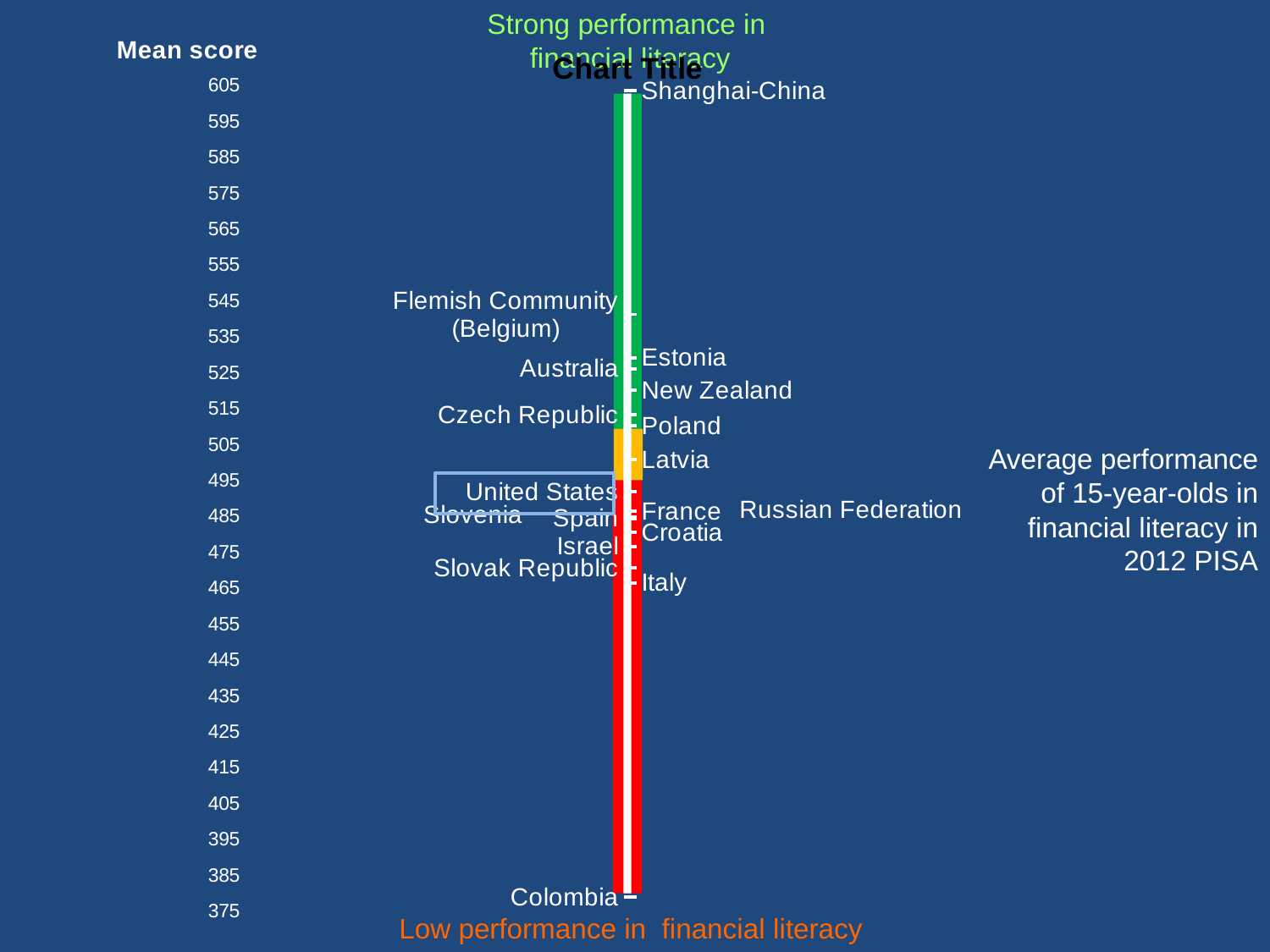
Is the mean score for Italy greater or less than 475? less Which country has the lowest mean score on the chart? Colombia What colour is the top segment of the vertical bar, where Shanghai-China is placed? Green Which country or economy has the highest mean score on the chart? Shanghai-China Is the mean score for Colombia greater or less than 395? less Is the mean score for Estonia greater or less than 515? greater Which has the higher mean score, the Flemish Community (Belgium) or the United States? Flemish Community (Belgium) Which has the higher mean score, Australia or Italy? Australia What is the label of the vertical axis on the chart? Mean score